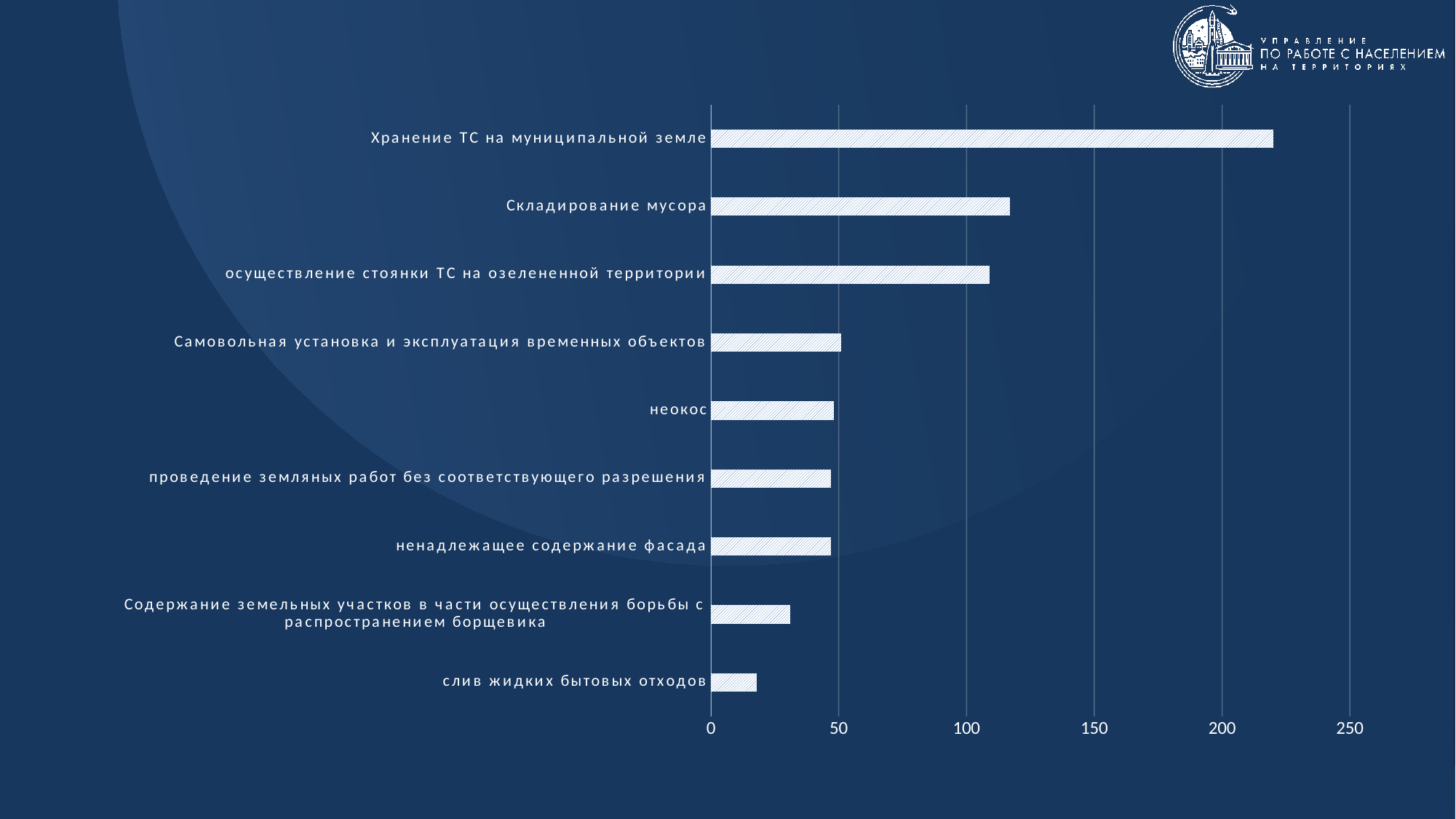
Is the value for Складирование мусора greater or less than 100? greater Is the value for Хранение ТС на муниципальной земле greater or less than 200? greater Is the value for Содержание земельных участков в части осуществления борьбы с распространением борщевика greater or less than 50? less Which is larger: the value for Содержание земельных участков в части осуществления борьбы с распространением борщевика or the value for слив жидких бытовых отходов? Содержание земельных участков в части осуществления борьбы с распространением борщевика Which category has the lowest value in the chart? слив жидких бытовых отходов Which is larger: the value for Хранение ТС на муниципальной земле or the value for Складирование мусора? Хранение ТС на муниципальной земле What is the highest tick value shown on the horizontal axis of the chart? 250 What kind of chart is shown on the slide? bar chart Which category has the highest value in the chart? Хранение ТС на муниципальной земле How many categories are plotted in the chart? 9